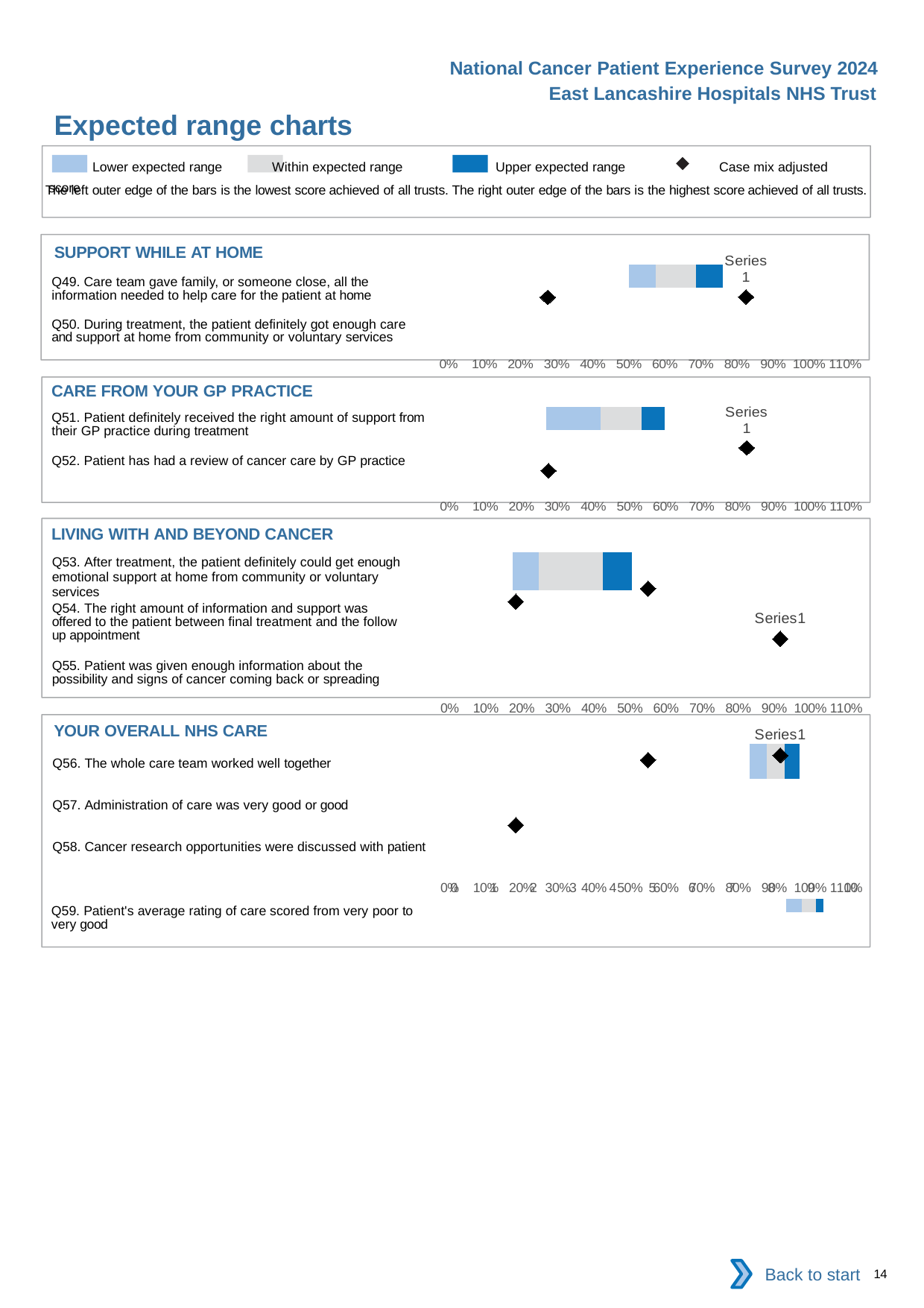
In the LIVING WITH AND BEYOND CANCER chart, is the left edge of the expected range bar greater or less than 30%? less In the CARE FROM YOUR GP PRACTICE chart, is the right edge of the expected range bar greater or less than 70%? less How many section charts are shown on the slide? 4 What is the highest value shown on the x axis of the CARE FROM YOUR GP PRACTICE chart? 110% How many questions are listed in the CARE FROM YOUR GP PRACTICE section? 2 What kind of chart is used in the SUPPORT WHILE AT HOME section? bar chart How many entries does the legend at the top of the slide list? 4 In the SUPPORT WHILE AT HOME chart, is the right edge of the expected range bar greater or less than 60%? greater How many questions are listed in the YOUR OVERALL NHS CARE section? 4